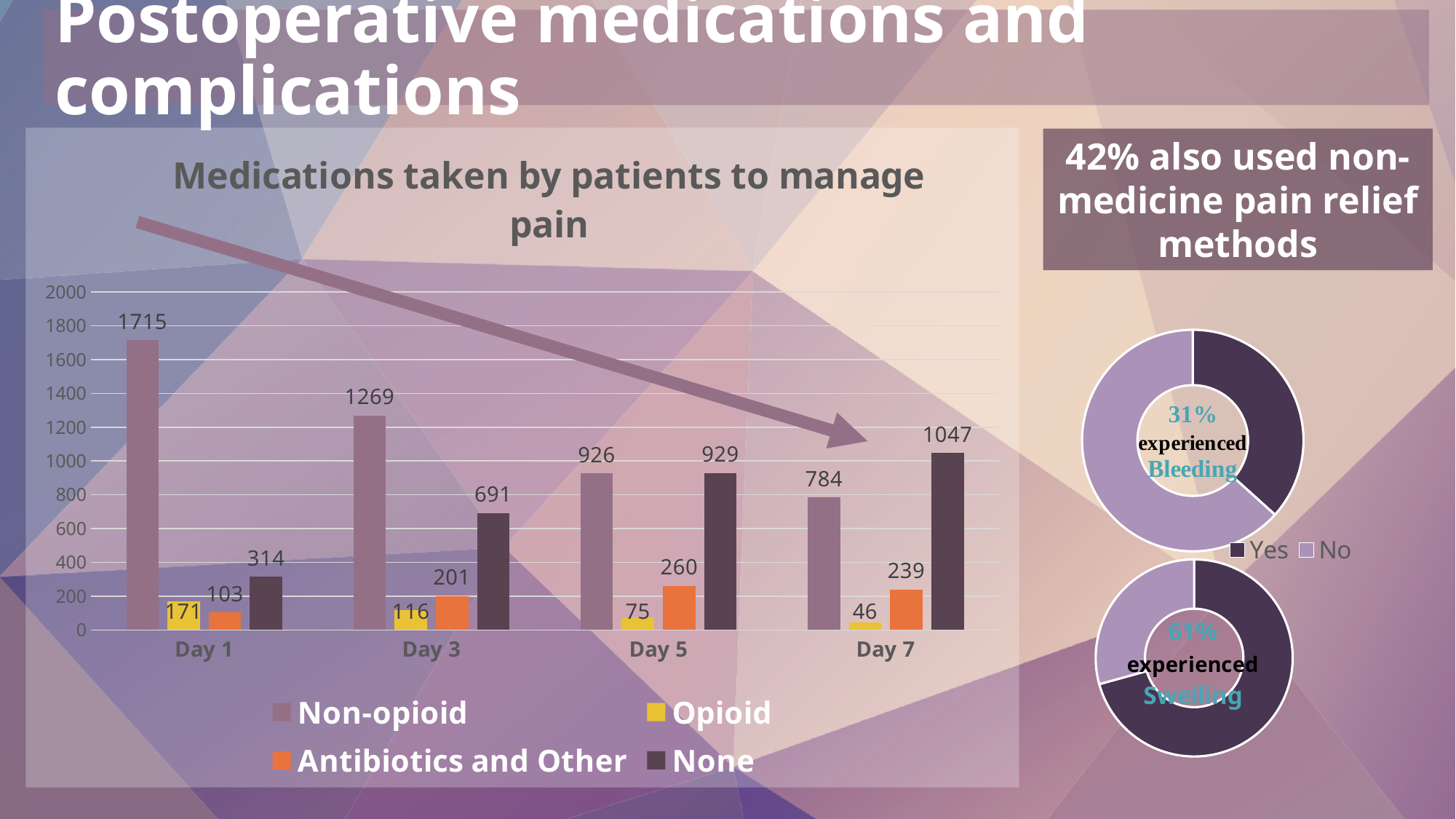
In the 'Medications taken by patients to manage pain' chart, how does the Non-opioid value change from Day 1 to Day 7? It falls How many day categories are shown on the x axis of the 'Medications taken by patients to manage pain' chart? 4 In the 'Medications taken by patients to manage pain' chart, what is the Antibiotics and Other value for Day 5? 260 What kind of chart is 'Medications taken by patients to manage pain'? Bar chart How many series does the legend of the 'Medications taken by patients to manage pain' chart list? 4 In the 'Medications taken by patients to manage pain' chart, what is the None value for Day 7? 1047 In the 'Medications taken by patients to manage pain' chart, on which day is the Non-opioid value highest? Day 1 In the 'Medications taken by patients to manage pain' chart, on which day is the Opioid value lowest? Day 7 In the upper donut chart on the right, what percentage of patients experienced Bleeding? 31% In the 'Medications taken by patients to manage pain' chart, what is the Non-opioid value for Day 1? 1715 In the 'Medications taken by patients to manage pain' chart, which is larger on Day 7: Non-opioid or None? None In the 'Medications taken by patients to manage pain' chart, what is the difference between the Non-opioid values for Day 1 and Day 3? 446